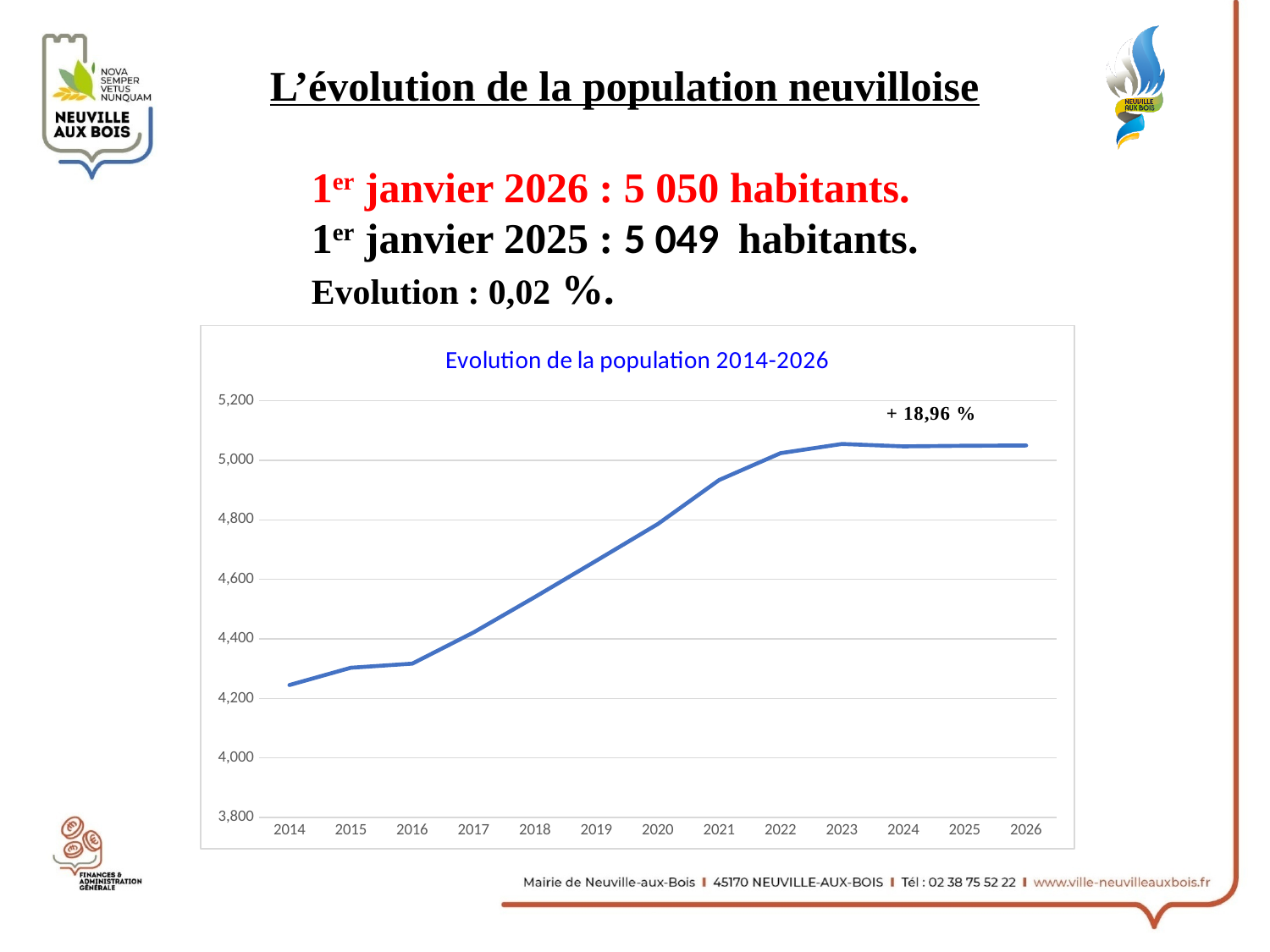
What percentage change is annotated on the chart near the end of the line? + 18,96 % Is the population value for 2018 greater or less than 4,400? greater Which year has the lowest population value on the chart? 2014 What kind of chart is shown on the slide? line chart Is the population value for 2014 greater or less than 4,400? less What is the title of the chart? Evolution de la population 2014-2026 How many years are plotted along the x axis of the chart? 13 Which year has the larger population value, 2017 or 2021? 2021 Is the population value for 2019 greater or less than 4,800? less Does the population generally rise or fall from 2014 to 2026? rise